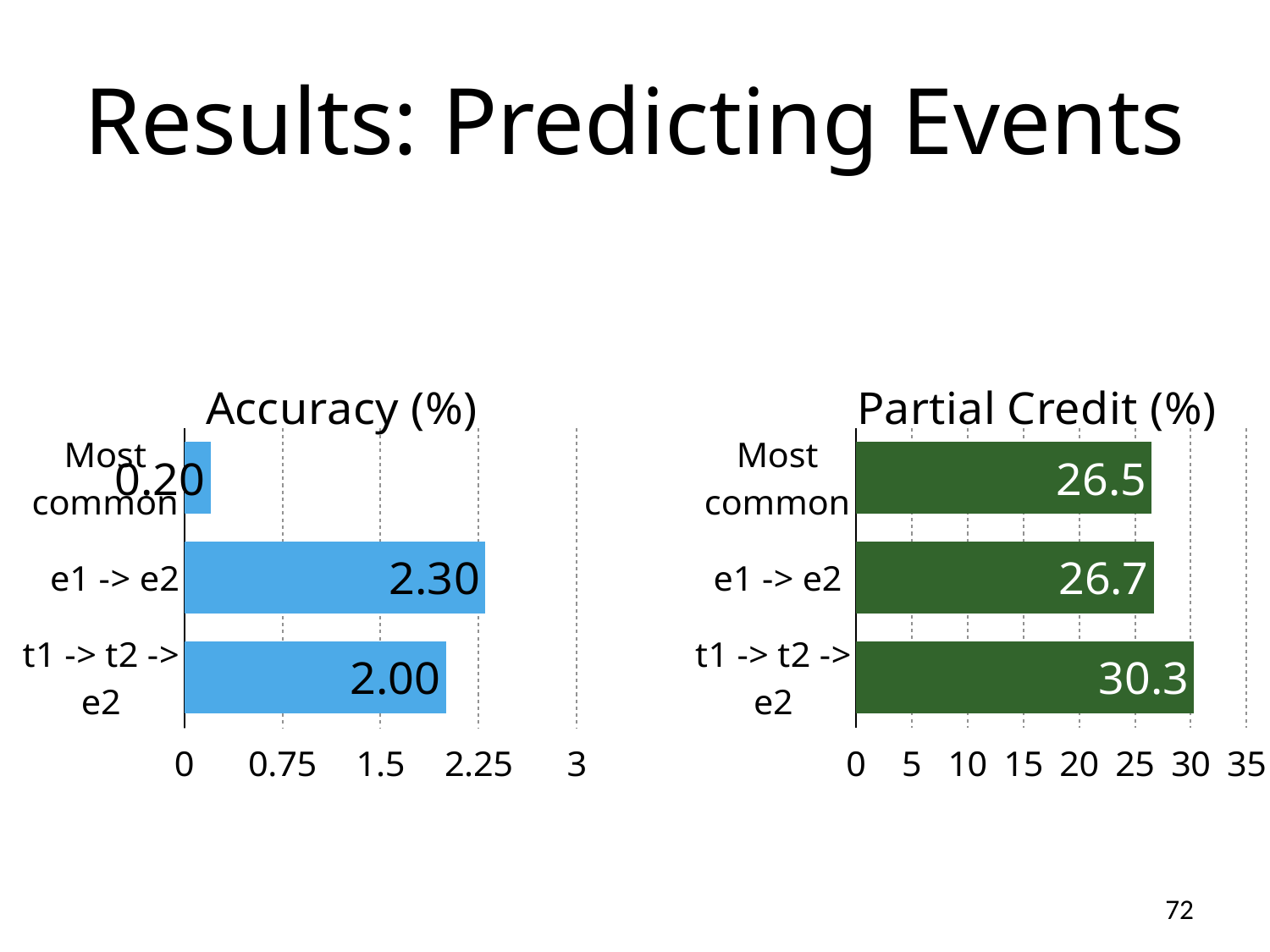
In the Accuracy (%) chart, what is the difference between e1 -> e2 and t1 -> t2 -> e2? 0.30 In the Accuracy (%) chart, which category has the highest value? e1 -> e2 How many categories does the Partial Credit (%) chart show? 3 In the Partial Credit (%) chart, what is the value for t1 -> t2 -> e2? 30.3 In the Accuracy (%) chart, what is the value for e1 -> e2? 2.30 In the Partial Credit (%) chart, what is the value for Most common? 26.5 What kind of chart is the Accuracy (%) chart? bar chart In the Partial Credit (%) chart, what is the difference between t1 -> t2 -> e2 and e1 -> e2? 3.6 In the Partial Credit (%) chart, which category has the lowest value? Most common In the Accuracy (%) chart, what is the value for Most common? 0.20 In the Partial Credit (%) chart, which category has the highest value? t1 -> t2 -> e2 In the Accuracy (%) chart, which is larger, the value for Most common or the value for t1 -> t2 -> e2? t1 -> t2 -> e2